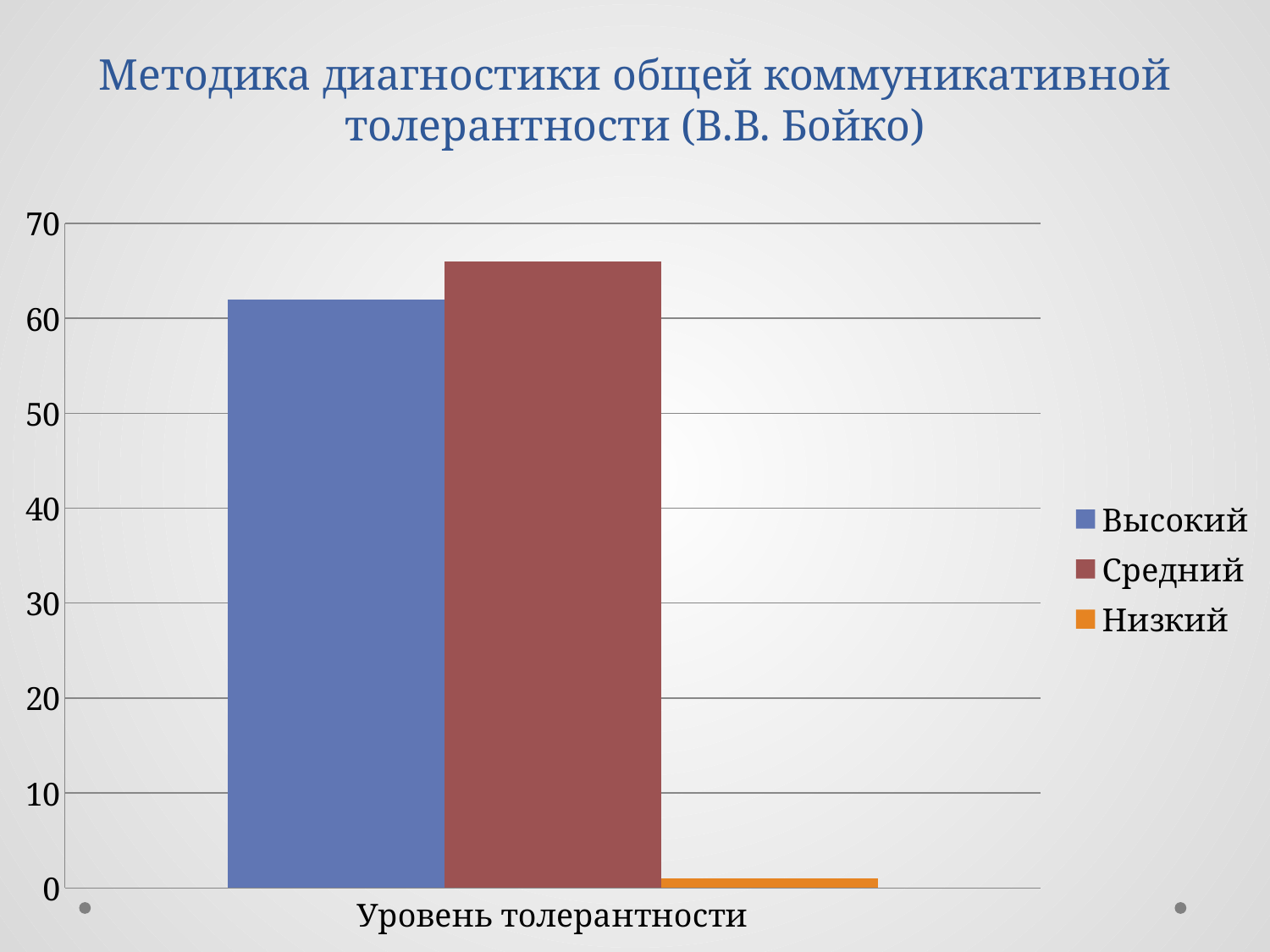
What kind of chart is shown on the slide? bar chart Which series has the lowest bar? Низкий Is the value for Средний greater or less than 60? greater What colour is the bar for the Низкий series? orange Which series has the highest bar? Средний How many categories are shown on the x axis? 1 Is the value for Высокий greater or less than 50? greater What is the label of the category on the x axis? Уровень толерантности Which is larger, the value for Высокий or the value for Средний? Средний Is the value for Низкий greater or less than 10? less How many series does the legend list? 3 Which is larger, the value for Высокий or the value for Низкий? Высокий